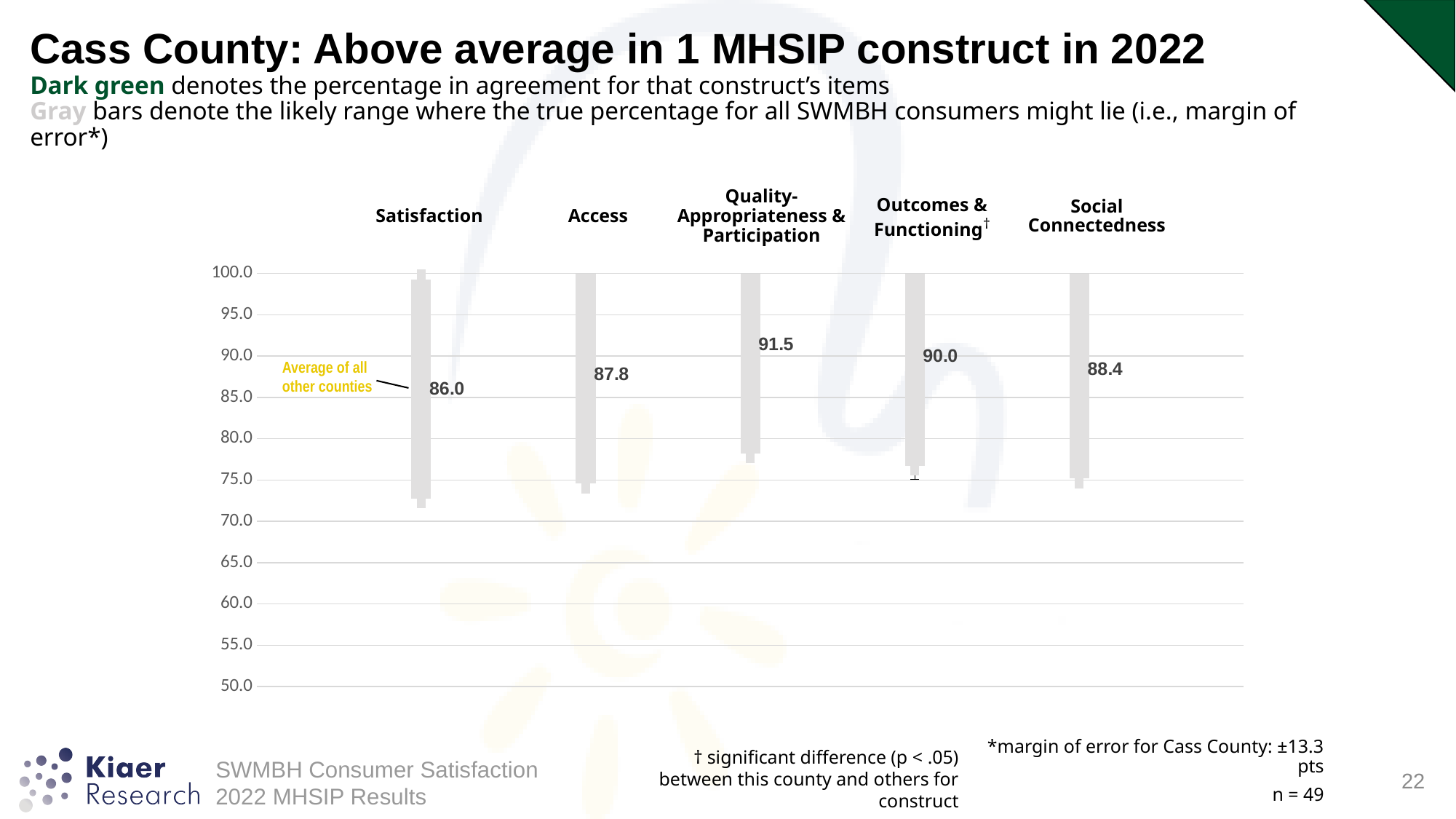
What kind of chart is shown on the slide? Bar chart Which has a higher printed average of all other counties, Access or Outcomes & Functioning? Outcomes & Functioning Which construct is marked with a dagger (†) indicating a significant difference? Outcomes & Functioning What is the average of all other counties for Satisfaction? 86.0 What is the average of all other counties for Social Connectedness? 88.4 What is the difference between the printed averages for Quality-Appropriateness & Participation and Satisfaction? 5.5 What is the average of all other counties for Quality-Appropriateness & Participation? 91.5 What is the average of all other counties for Outcomes & Functioning? 90.0 How many MHSIP constructs are shown on the chart? 5 Which construct has the highest printed average of all other counties? Quality-Appropriateness & Participation Which construct has the lowest printed average of all other counties? Satisfaction What is the average of all other counties for Access? 87.8